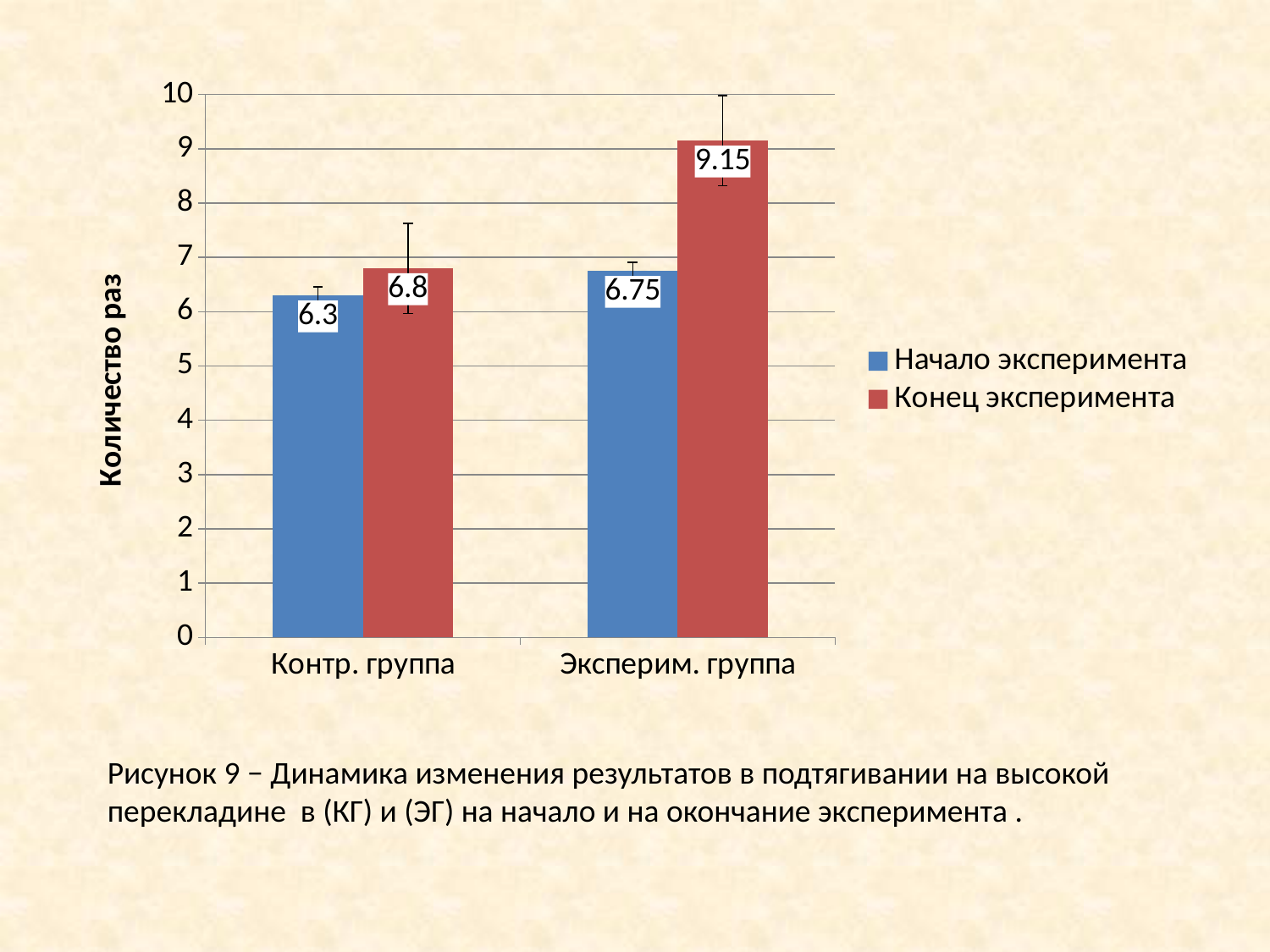
What is the difference between the Конец эксперимента and Начало эксперимента values for Эксперим. группа? 2.4 Which is larger: the Конец эксперимента value for Контр. группа or for Эксперим. группа? Эксперим. группа What is the value for Эксперим. группа at Начало эксперимента? 6.75 What is the value for Контр. группа at Начало эксперимента? 6.3 What kind of chart is shown on the slide? Bar chart How many groups are shown on the x axis? 2 What is the difference between the Конец эксперимента and Начало эксперимента values for Контр. группа? 0.5 What is the value for Эксперим. группа at Конец эксперимента? 9.15 Which group has the highest value for Конец эксперимента? Эксперим. группа What is the value for Контр. группа at Конец эксперимента? 6.8 How many series does the legend list? 2 Which group has the lowest value for Начало эксперимента? Контр. группа